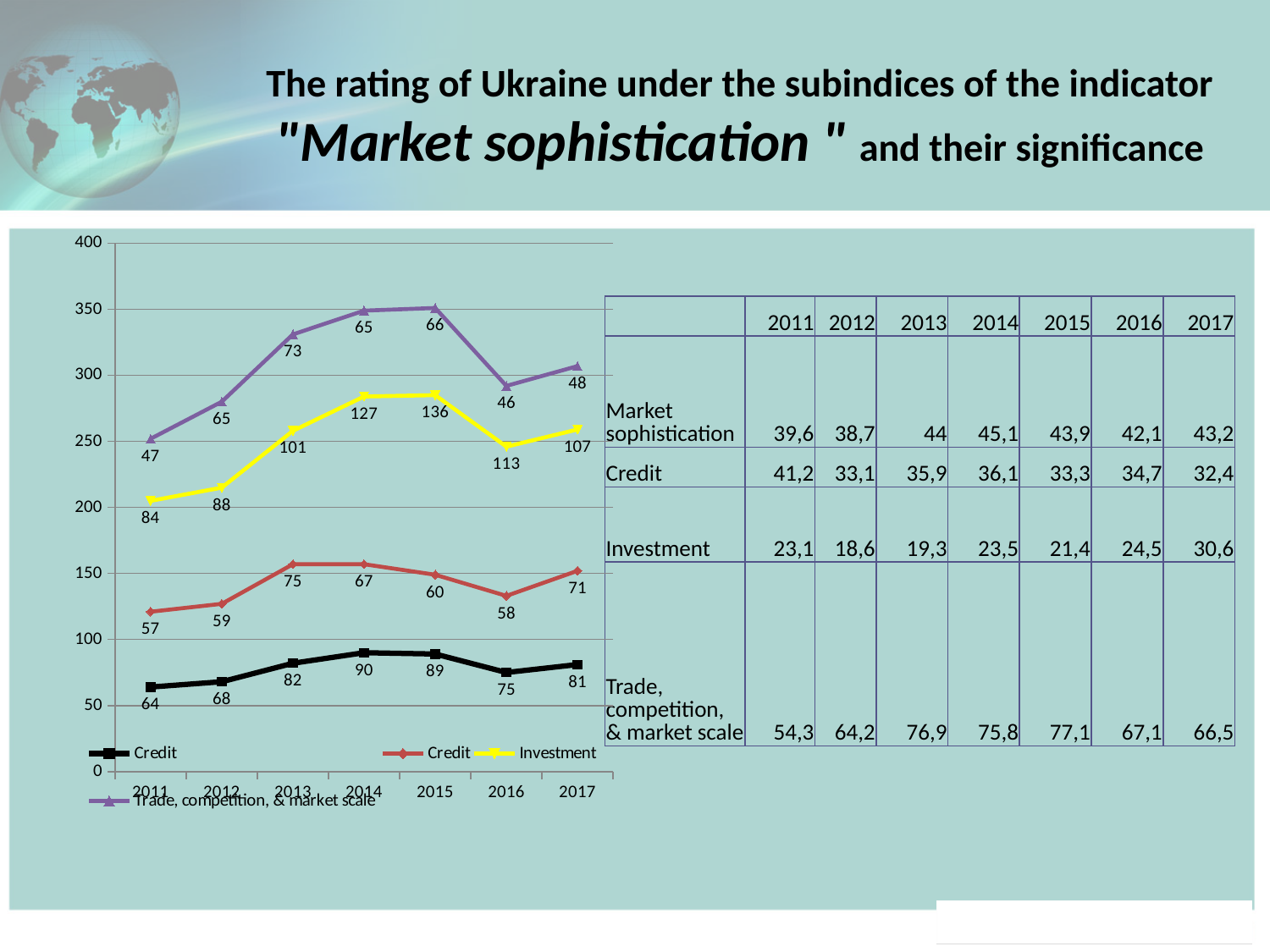
How many years are plotted along the x axis of the chart? 7 Which is larger for Investment: the 2014 value or the 2015 value? 2015 What is the data label for the black Credit line in 2014? 90 How many series does the chart legend list? 4 In which year does the Investment series have its highest data label? 2015 What is the difference between the Investment data labels for 2016 and 2017? 6 What kind of chart is shown on the slide? line chart In which year does the Trade, competition, & market scale series have its lowest data label? 2016 What is the data label for Trade, competition, & market scale in 2013? 73 In which year does the black Credit line have its lowest data label? 2011 Do the Investment data labels rise or fall from 2011 to 2015? rise What is the data label for Investment in 2015? 136